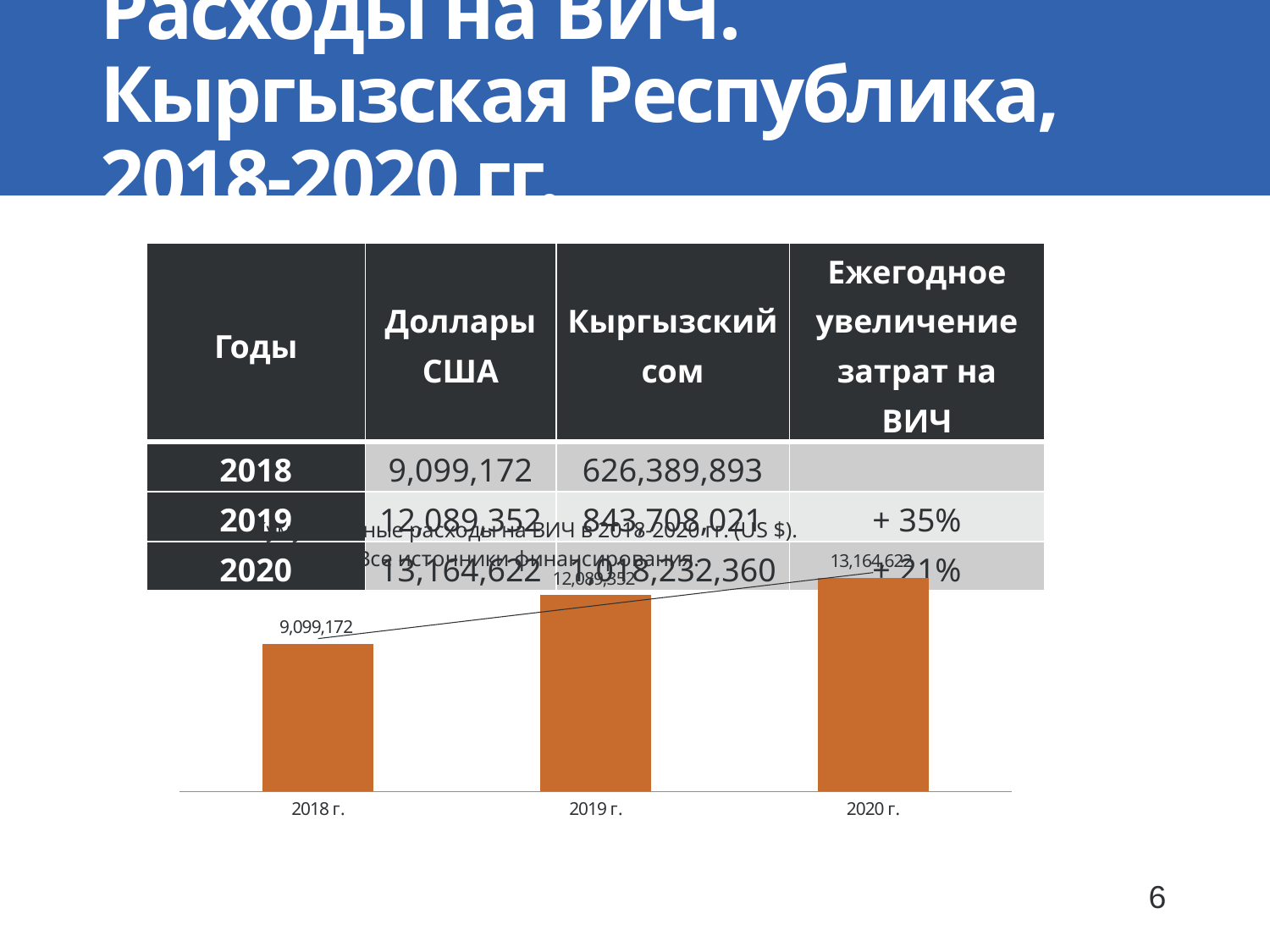
What is the difference between the values for 2020 г. and 2018 г.? 4,065,450 What colour are the bars in the chart? orange What is the value of the bar for 2019 г.? 12,089,352 Which year has the lowest bar in the chart? 2018 г. Which bar is larger, 2018 г. or 2019 г.? 2019 г. What is the value of the bar for 2020 г.? 13,164,622 What kind of chart is shown on the slide? bar chart Which year has the highest bar in the chart? 2020 г. What is the value of the bar for 2018 г.? 9,099,172 Do the bar values rise or fall from 2018 г. to 2020 г.? rise What is the difference between the values for 2019 г. and 2018 г.? 2,990,180 How many bars (years) are plotted in the chart? 3